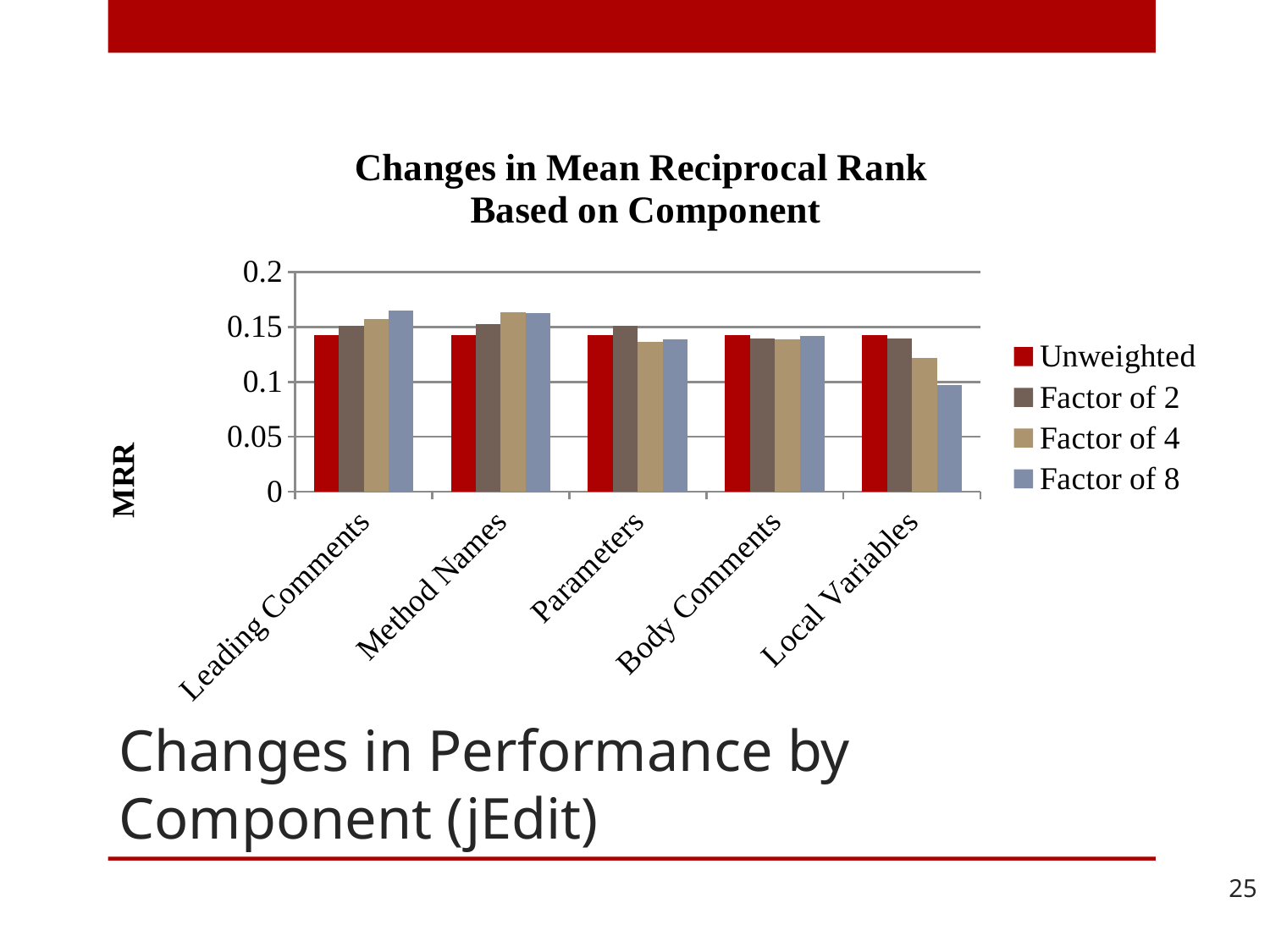
What kind of chart is shown on the slide? bar chart Is the Factor of 4 value for Method Names greater or less than 0.15? greater Which category has the lowest Factor of 8 value? Local Variables For Local Variables, which is larger: the Unweighted value or the Factor of 8 value? Unweighted Is the Factor of 4 value for Local Variables greater or less than 0.15? less What is the title of the chart? Changes in Mean Reciprocal Rank Based on Component For Local Variables, which series has the lowest value? Factor of 8 What is the label on the y axis of the chart? MRR How many series does the legend list? 4 Is the Factor of 8 value for Leading Comments greater or less than 0.15? greater How many categories are shown on the x axis of the chart? 5